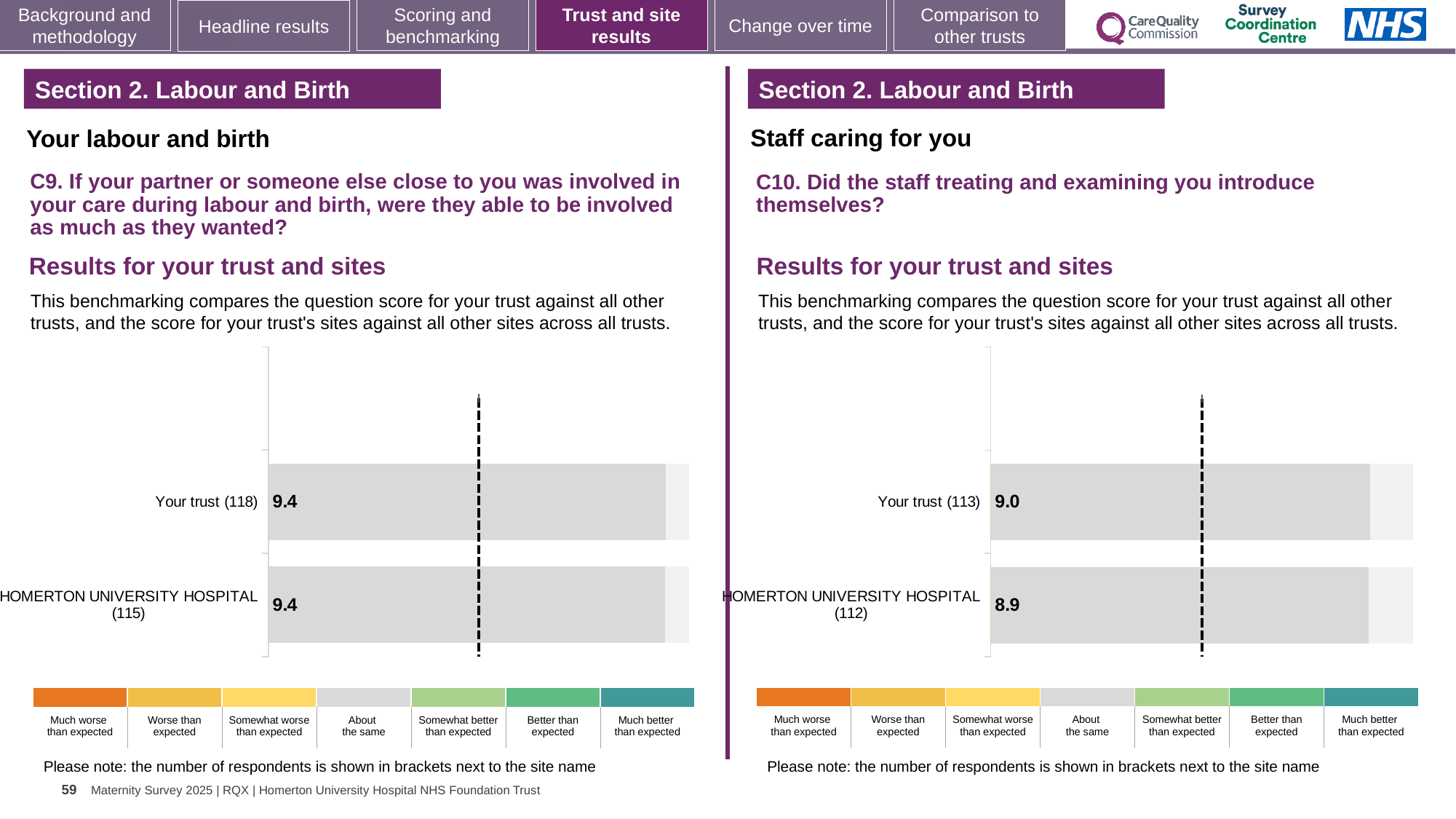
In the left chart (C9), what is the score for Homerton University Hospital? 9.4 In the left chart (C9), what is the score for Your trust? 9.4 In the left chart (C9), what is the difference between the score for Your trust and the score for Homerton University Hospital? 0.0 What type of chart is used in the right chart (C10)? Bar chart In the right chart (C10), which has the lower score, Your trust or Homerton University Hospital? Homerton University Hospital In the left chart (C9), how many respondents are shown in brackets for Your trust? 118 In the right chart (C10), what is the score for Homerton University Hospital? 8.9 How many bars are plotted in the left chart (C9)? 2 In the right chart (C10), how many respondents are shown in brackets for Homerton University Hospital? 112 In the right chart (C10), which has the higher score, Your trust or Homerton University Hospital? Your trust In the right chart (C10), what is the score for Your trust? 9.0 In the right chart (C10), what is the difference between the score for Your trust and the score for Homerton University Hospital? 0.1